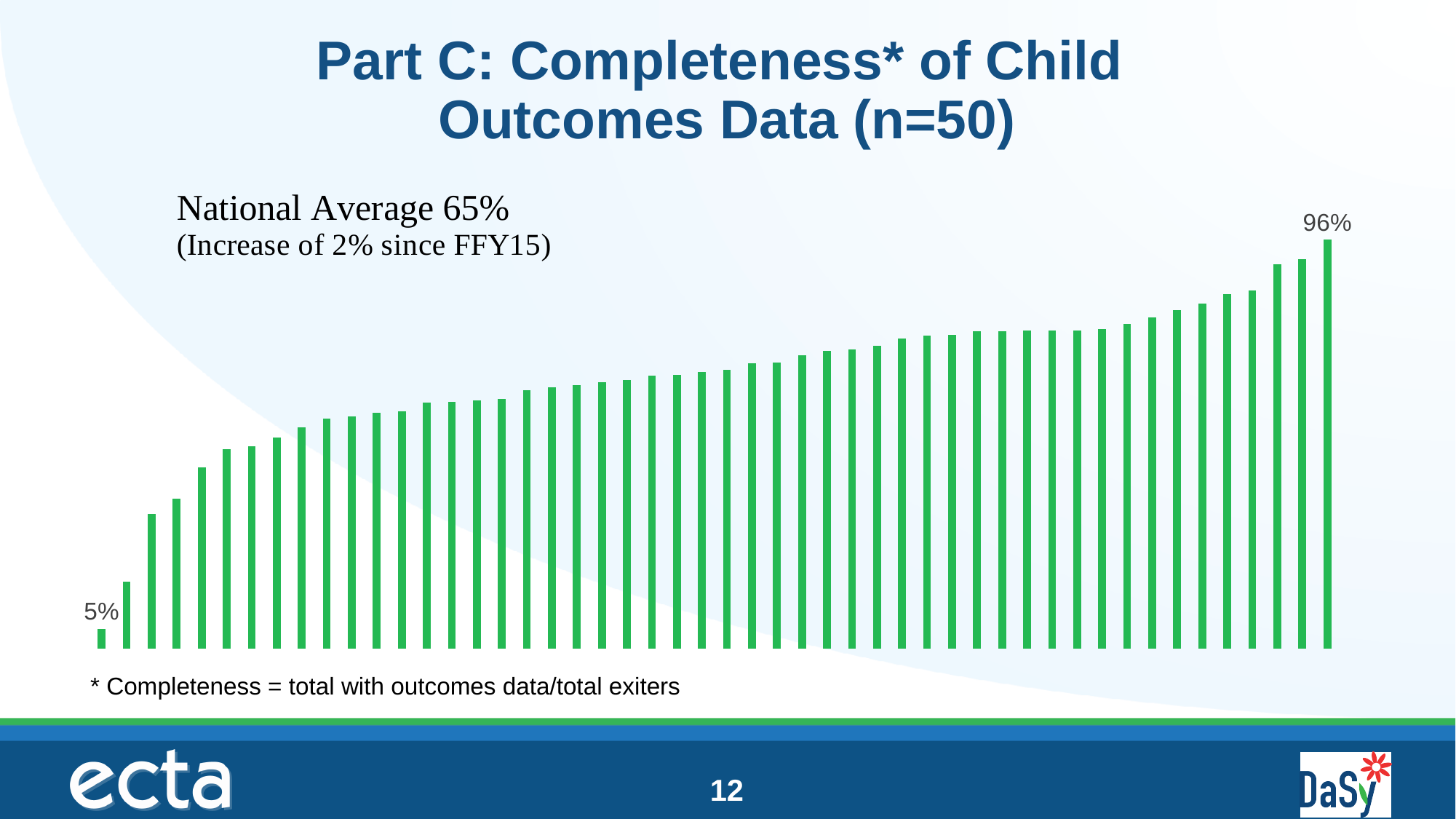
Which is larger, the leftmost bar or the rightmost bar? The rightmost bar What is the highest value shown in the chart? 96% What is the lowest value shown in the chart? 5% What is the difference between the highest labeled value (96%) and the lowest labeled value (5%) in the chart? 91 percentage points Do the bar values rise or fall from left to right across the chart? Rise What national average is stated on the slide? 65% How many bars (states/entities) are plotted in the chart? 50 By how much has the national average increased since FFY15, according to the slide? 2% What kind of chart is shown on the slide? Bar chart